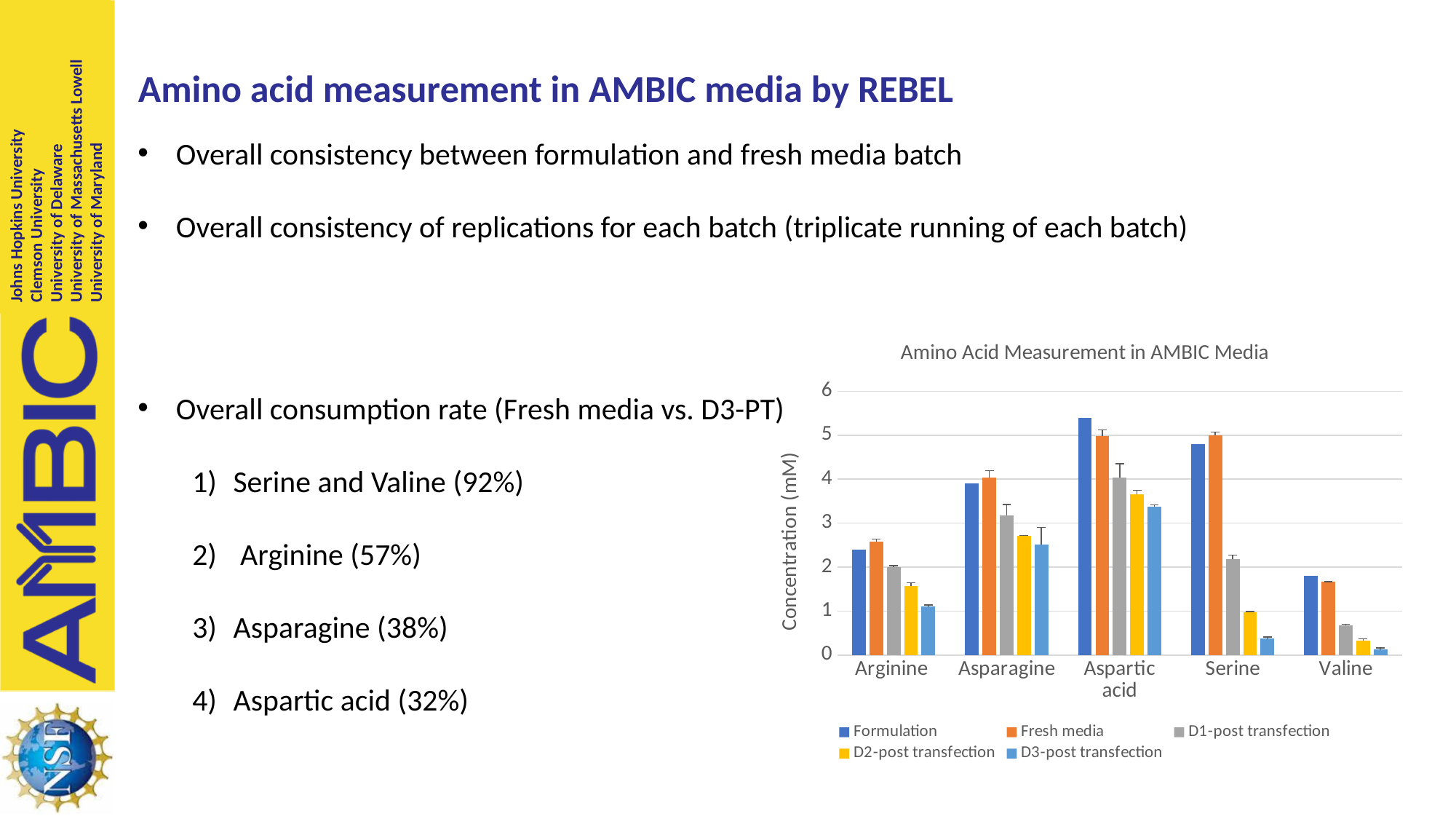
Which amino acid has the highest Formulation concentration? Aspartic acid What kind of chart is shown on the slide? Bar chart Which amino acid has the lowest D3-post transfection concentration? Valine What is the title of the chart? Amino Acid Measurement in AMBIC Media Is the Formulation value for Aspartic acid greater or less than 5? greater What is the label on the y axis of the chart? Concentration (mM) Is the Formulation value for Valine greater or less than 2? less Which is larger, the Formulation value for Arginine or the Formulation value for Asparagine? Asparagine How many series does the chart legend list? 5 How many amino acid categories are shown on the x axis? 5 For Serine, do the values rise or fall from Formulation through D3-post transfection? fall Is the D3-post transfection value for Serine greater or less than 1? less